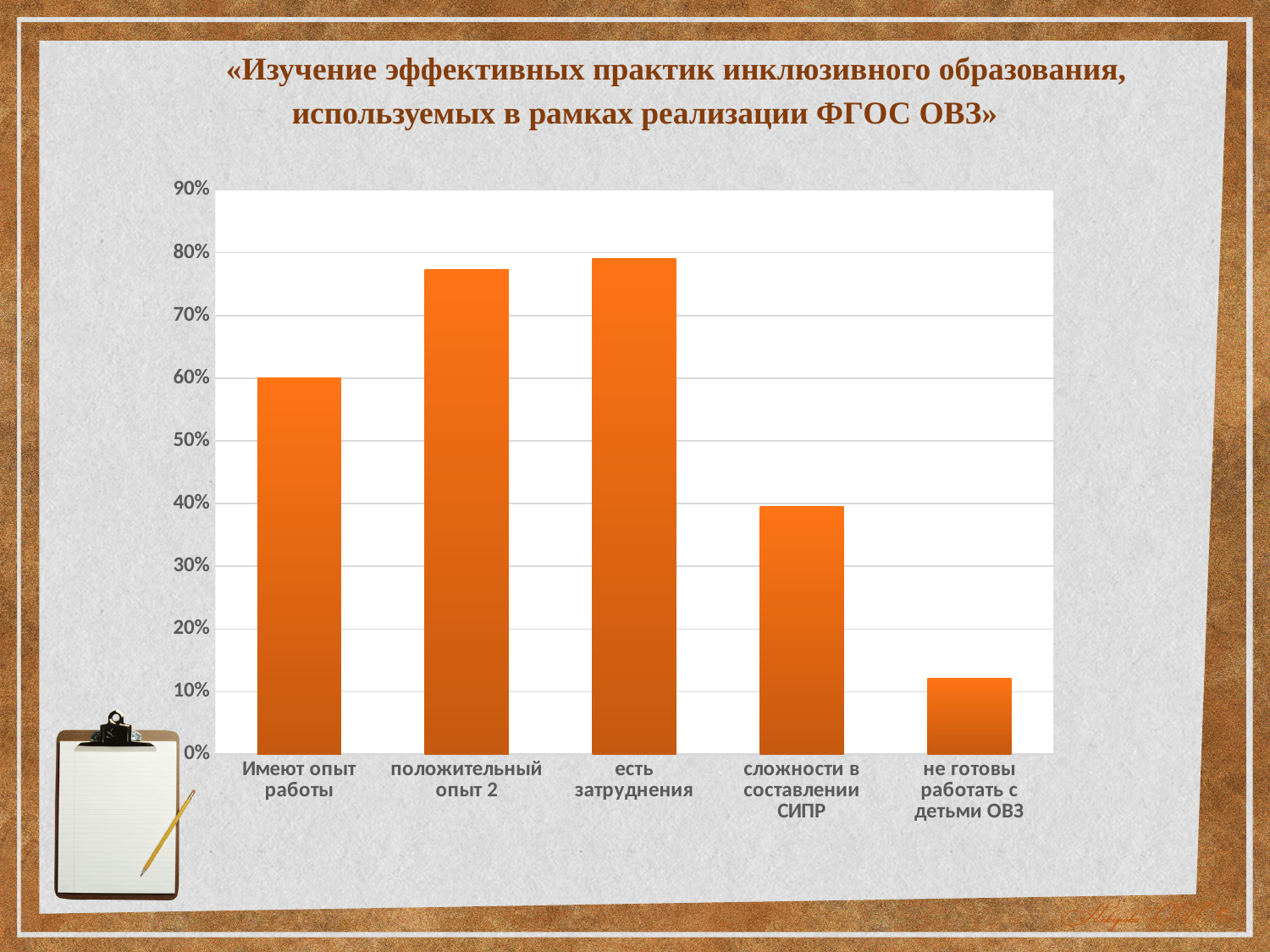
What colour are the bars in the chart? orange Is the value for "не готовы работать с детьми ОВЗ" greater or less than 20%? less How many categories are shown on the x axis of the chart? 5 Which category has the lowest value in the chart? не готовы работать с детьми ОВЗ Is the value for "положительный опыт 2" greater or less than 70%? greater Is the value for "Имеют опыт работы" greater or less than 50%? greater Which is larger: the value for "Имеют опыт работы" or the value for "сложности в составлении СИПР"? Имеют опыт работы Which is larger: the value for "положительный опыт 2" or the value for "не готовы работать с детьми ОВЗ"? положительный опыт 2 What kind of chart is shown on the slide? bar chart What is the highest value shown on the y axis of the chart? 90%